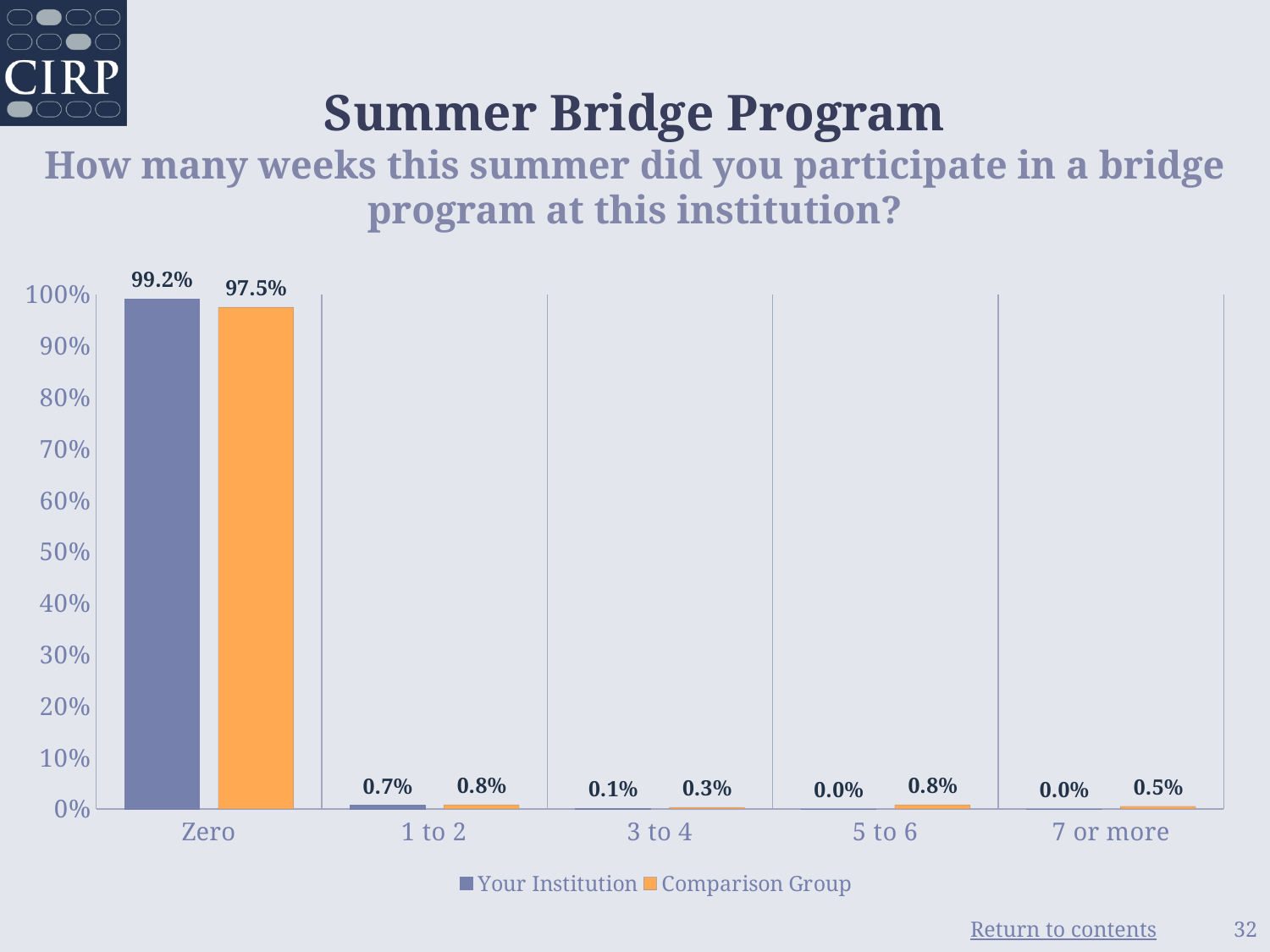
How many series does the legend list? 2 Which category has the highest value for Your Institution? Zero What is the value for Your Institution in the 3 to 4 category? 0.1% What kind of chart is shown on the slide? Bar chart How many categories are shown on the x axis? 5 What is the value for Comparison Group in the Zero category? 97.5% What is the value for Your Institution in the Zero category? 99.2% Which category has the lowest value for Comparison Group? 3 to 4 In the 7 or more category, which series has the larger value, Your Institution or Comparison Group? Comparison Group What colour are the bars for Comparison Group? Orange What is the value for Comparison Group in the 5 to 6 category? 0.8% What is the difference between Your Institution and Comparison Group in the Zero category? 1.7%